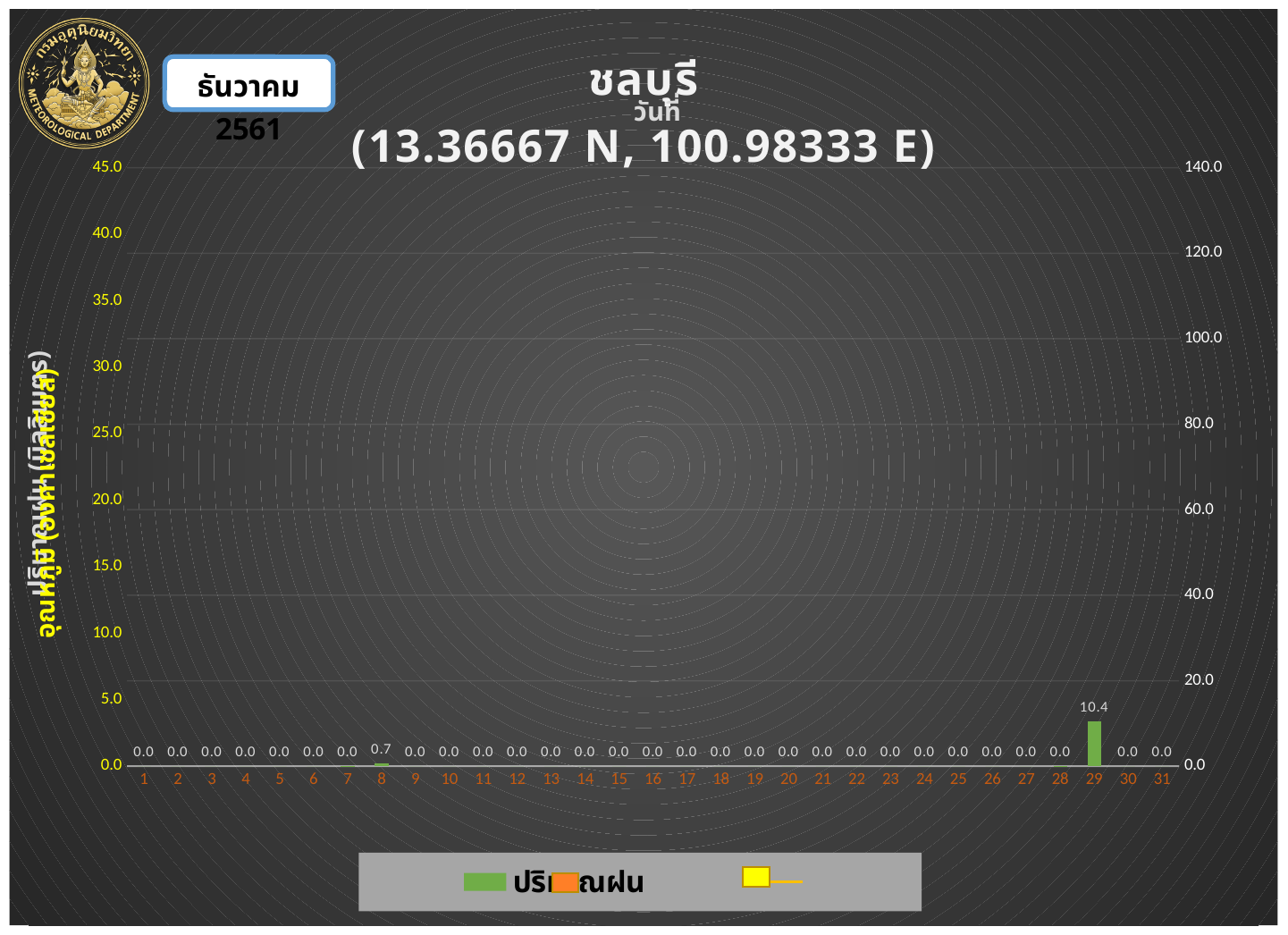
Which day has the highest rainfall value? 29 What is the rainfall value shown for day 8? 0.7 What is the difference between the rainfall values for day 29 and day 8? 9.7 How many days have a rainfall value greater than 0.0? 2 What is the highest tick value on the left y axis? 45.0 What is the rainfall value shown for day 29? 10.4 What is the rainfall value shown for day 15? 0.0 What kind of chart is used to show the rainfall values? bar chart Which has the larger rainfall value, day 8 or day 29? 29 How many days are shown on the x axis? 31 What is the name of the station in the chart title? ชลบุรี Is the rainfall value for day 29 greater or less than 15.0 on the left axis? less